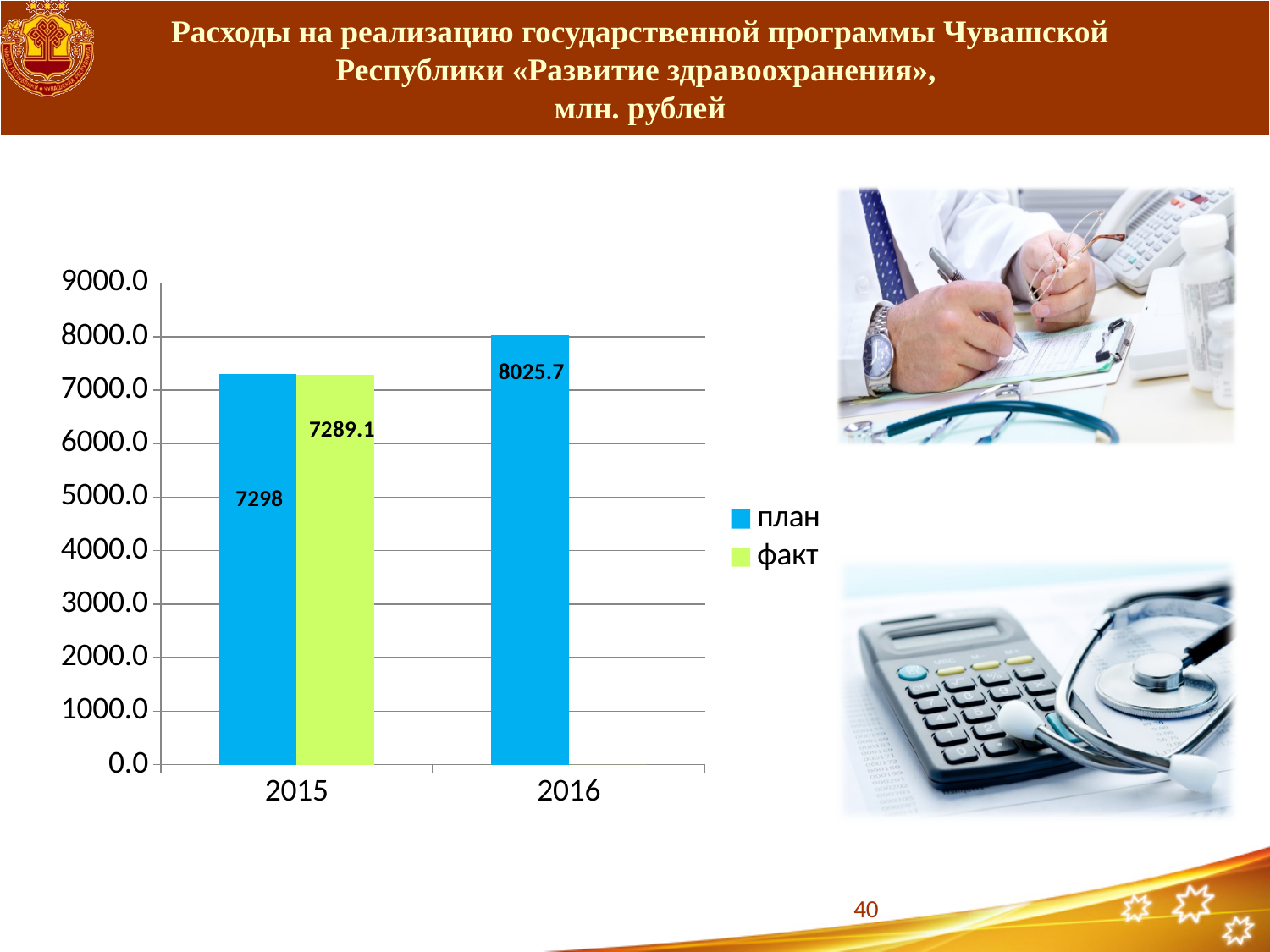
Does the план value rise or fall from 2015 to 2016? rise In which year is the план value highest? 2016 Which is larger, the план value for 2016 or the план value for 2015? план for 2016 What is the difference between план and факт for 2015? 8.9 How many series does the legend list? 2 How many years are shown on the x axis? 2 What is the value of план for 2015? 7298 What is the value of факт for 2015? 7289.1 Is the план value for 2015 greater or less than 7000? greater What is the difference between the план values for 2016 and 2015? 727.7 What is the value of план for 2016? 8025.7 What kind of chart is shown on the slide? bar chart